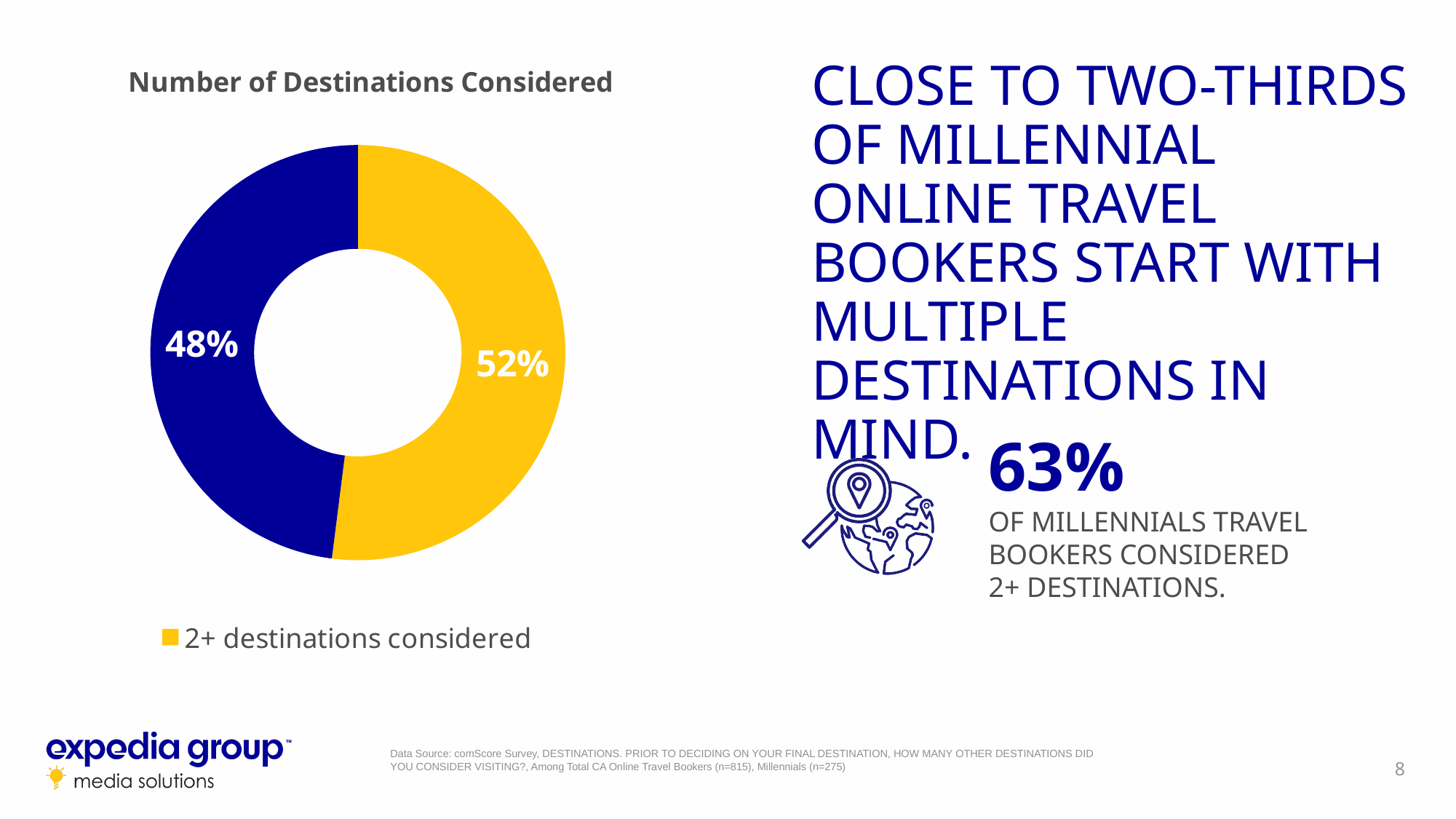
Which slice of the chart is the largest? 2+ destinations considered (52%) What percentage of the chart is labelled for '2+ destinations considered'? 52% How many entries does the chart legend list? 1 Which slice of the chart is the smallest? The dark blue slice (48%) What is the title of the chart? Number of Destinations Considered What do the two slices of the chart add up to? 100% What colour represents '2+ destinations considered' in the chart? Yellow What is the difference between the two slices of the chart? 4 percentage points What value is shown on the dark blue slice of the chart? 48% What kind of chart is shown on the slide? Donut (pie) chart How many slices does the chart have? 2 Which is larger: the yellow slice or the dark blue slice? The yellow slice (52%)